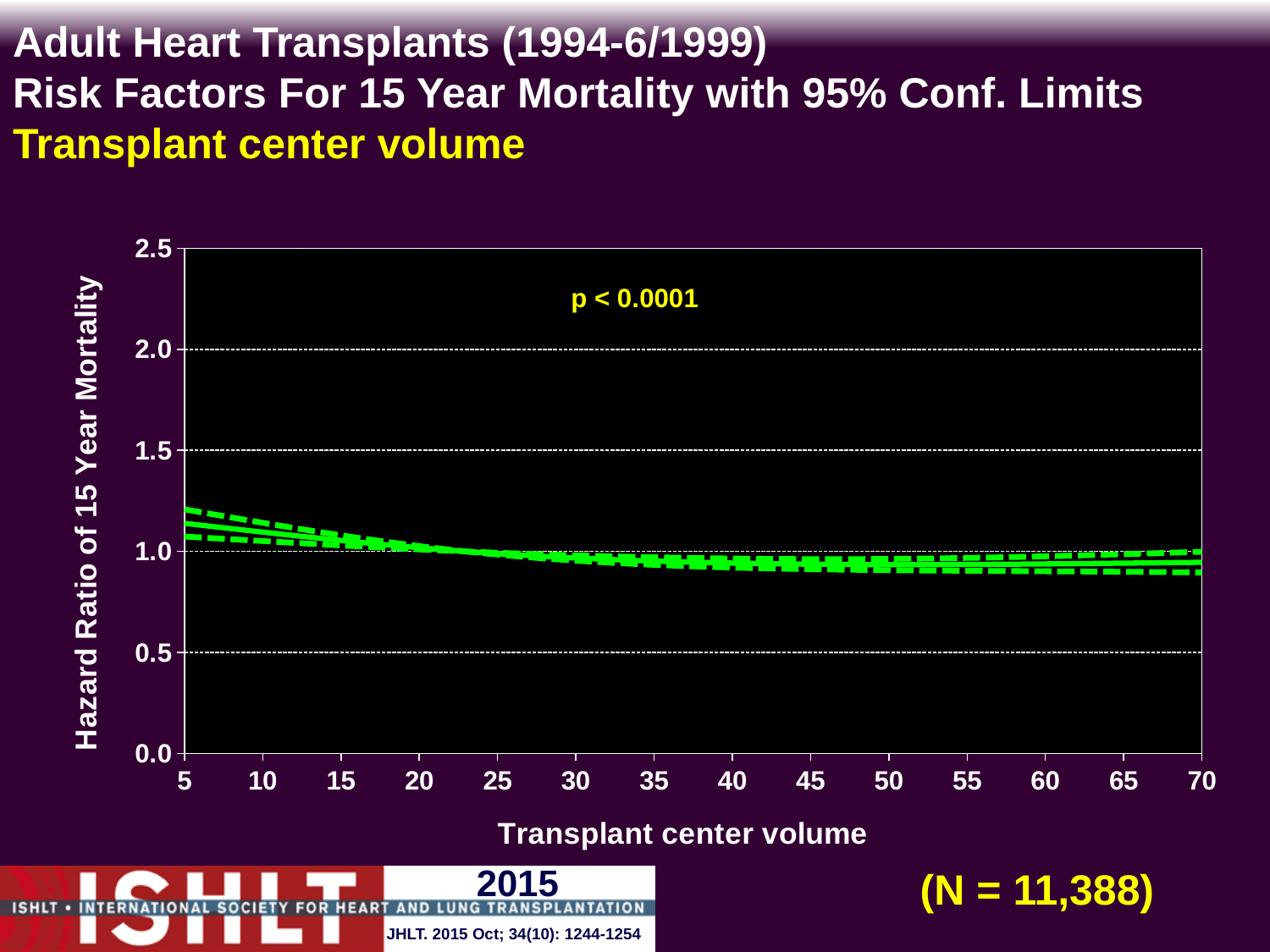
Is the hazard ratio at a transplant center volume of 70 greater or less than 1.0? less Which transplant center volume has the highest hazard ratio, 10 or 40? 10 Is the hazard ratio at a transplant center volume of 5 greater or less than 1.0? greater Is the hazard ratio at a transplant center volume of 5 greater or less than 1.5? less What is the title of the y axis? Hazard Ratio of 15 Year Mortality At which transplant center volume on the x axis is the hazard ratio highest? 5 What is the highest value labelled on the y axis? 2.5 What kind of chart is shown on the slide? line chart Does the hazard ratio rise or fall as transplant center volume increases from 5 to 40? fall What is the title of the x axis? Transplant center volume How many tick labels are shown on the x axis? 14